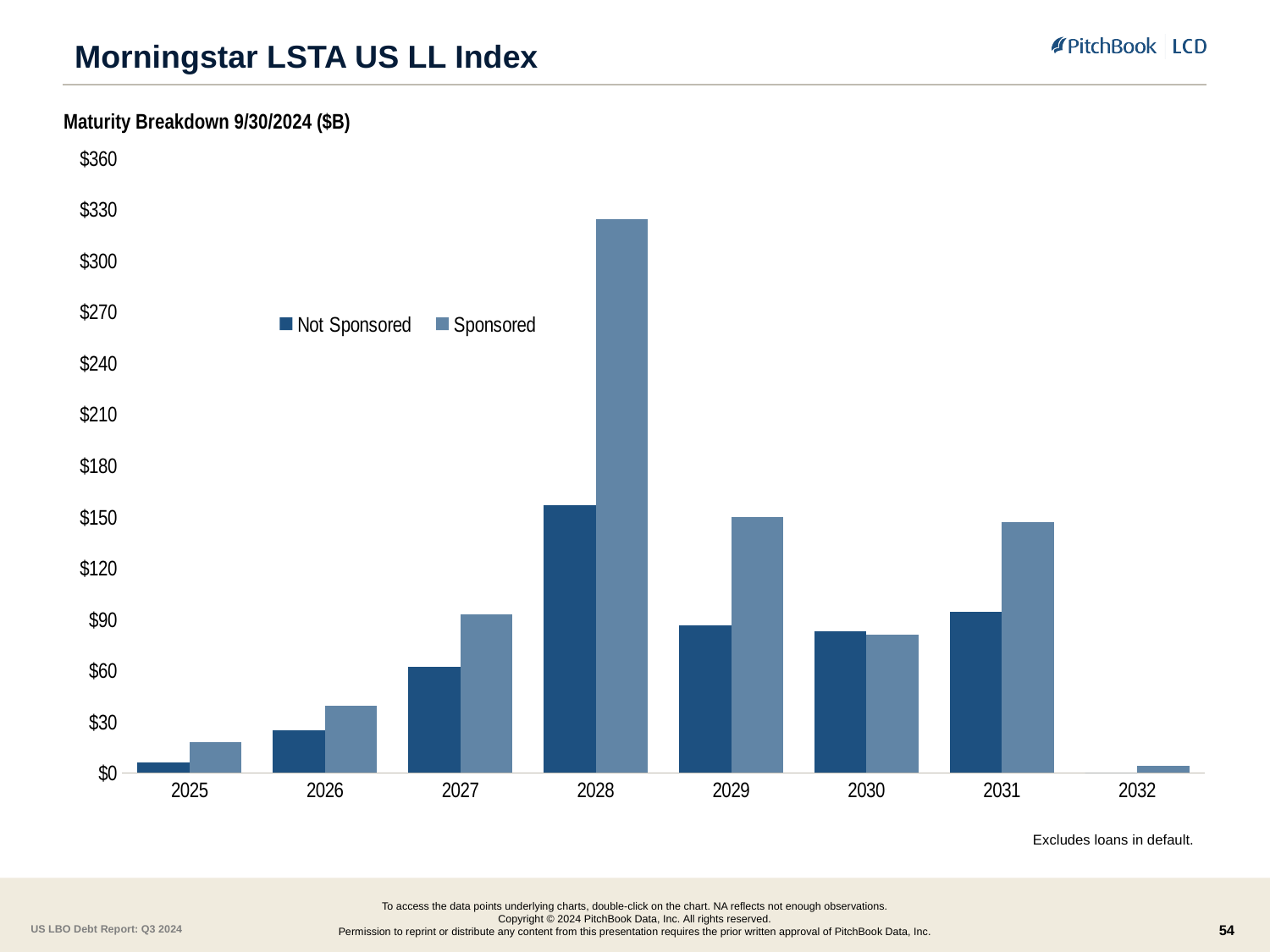
How many series does the legend list? 2 In 2029, which is larger, the Sponsored or the Not Sponsored value? Sponsored Is the Sponsored value for 2028 greater or less than $300? greater Which year has the highest Sponsored value? 2028 Which is larger, the Sponsored value for 2031 or the Sponsored value for 2027? 2031 Is the Sponsored value for 2029 greater or less than $120? greater What is the title of the chart? Maturity Breakdown 9/30/2024 ($B) Is the Not Sponsored value for 2027 greater or less than $90? less Which year has the highest Not Sponsored value? 2028 Which year has the lowest Sponsored value? 2032 What kind of chart is shown on the slide? Bar chart How many maturity years are shown on the x axis? 8